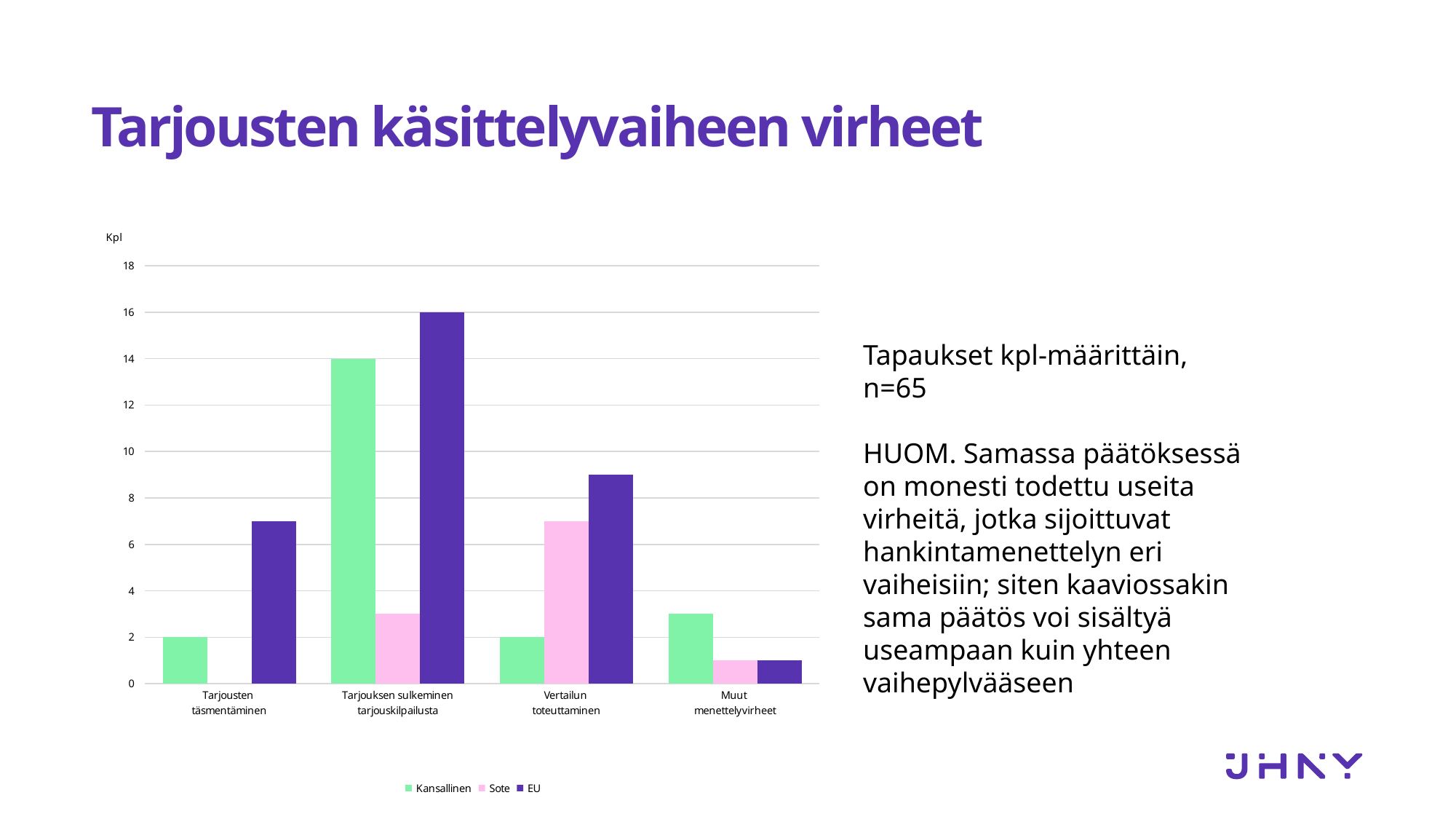
What is the value for Kansallinen in the category Tarjouksen sulkeminen tarjouskilpailusta? 14 In the category Vertailun toteuttaminen, which is larger: the Sote value or the Kansallinen value? Sote How many series does the legend list? 3 Is the value for EU in the category Tarjousten täsmentäminen greater or less than 6? greater Which category has the highest bar in the chart? Tarjouksen sulkeminen tarjouskilpailusta Is the value for EU in the category Vertailun toteuttaminen greater or less than 8? greater How many categories are shown on the x axis? 4 What is the value for Kansallinen in the category Tarjousten täsmentäminen? 2 What is the value for EU in the category Tarjouksen sulkeminen tarjouskilpailusta? 16 What unit label is shown on the y axis of the chart? Kpl What is the difference between the EU and Kansallinen values in the category Tarjouksen sulkeminen tarjouskilpailusta? 2 What kind of chart is shown on the slide? bar chart